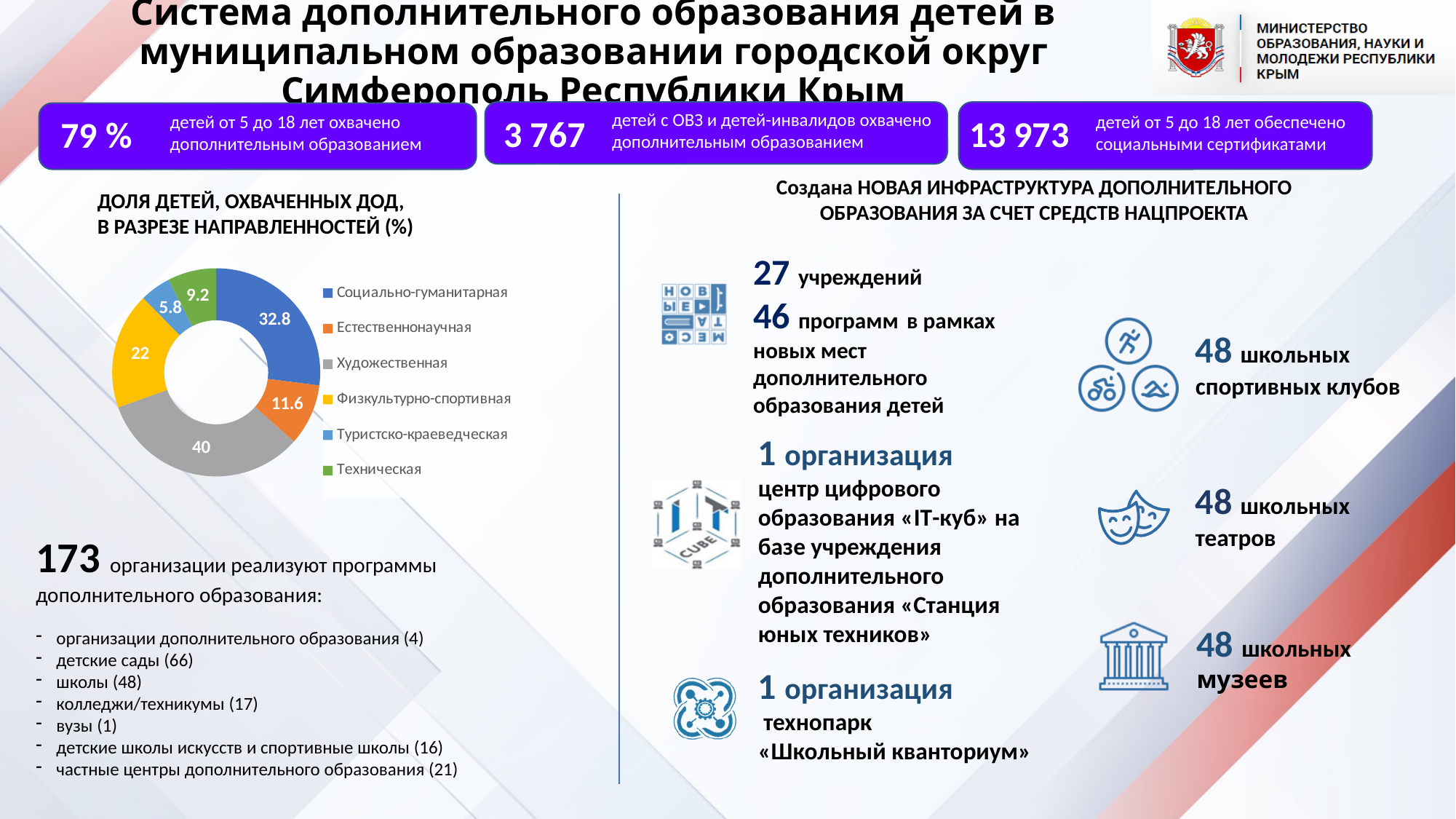
Which direction has the largest share in the doughnut chart? Художественная Which is larger in the doughnut chart: Естественнонаучная or Техническая? Естественнонаучная What is the difference between the values for Физкультурно-спортивная and Естественнонаучная in the doughnut chart? 10.4 What is the value for Туристско-краеведческая in the doughnut chart? 5.8 What is the value for Физкультурно-спортивная in the doughnut chart? 22 How many categories does the doughnut chart show? 6 What type of chart is used to show the share of children covered by additional education by direction? Doughnut (pie) chart What colour represents Физкультурно-спортивная in the doughnut chart? Yellow What is the difference between the values for Художественная and Социально-гуманитарная in the doughnut chart? 7.2 What is the value for Художественная in the doughnut chart? 40 Which direction has the smallest share in the doughnut chart? Туристско-краеведческая What is the value for Социально-гуманитарная in the doughnut chart? 32.8